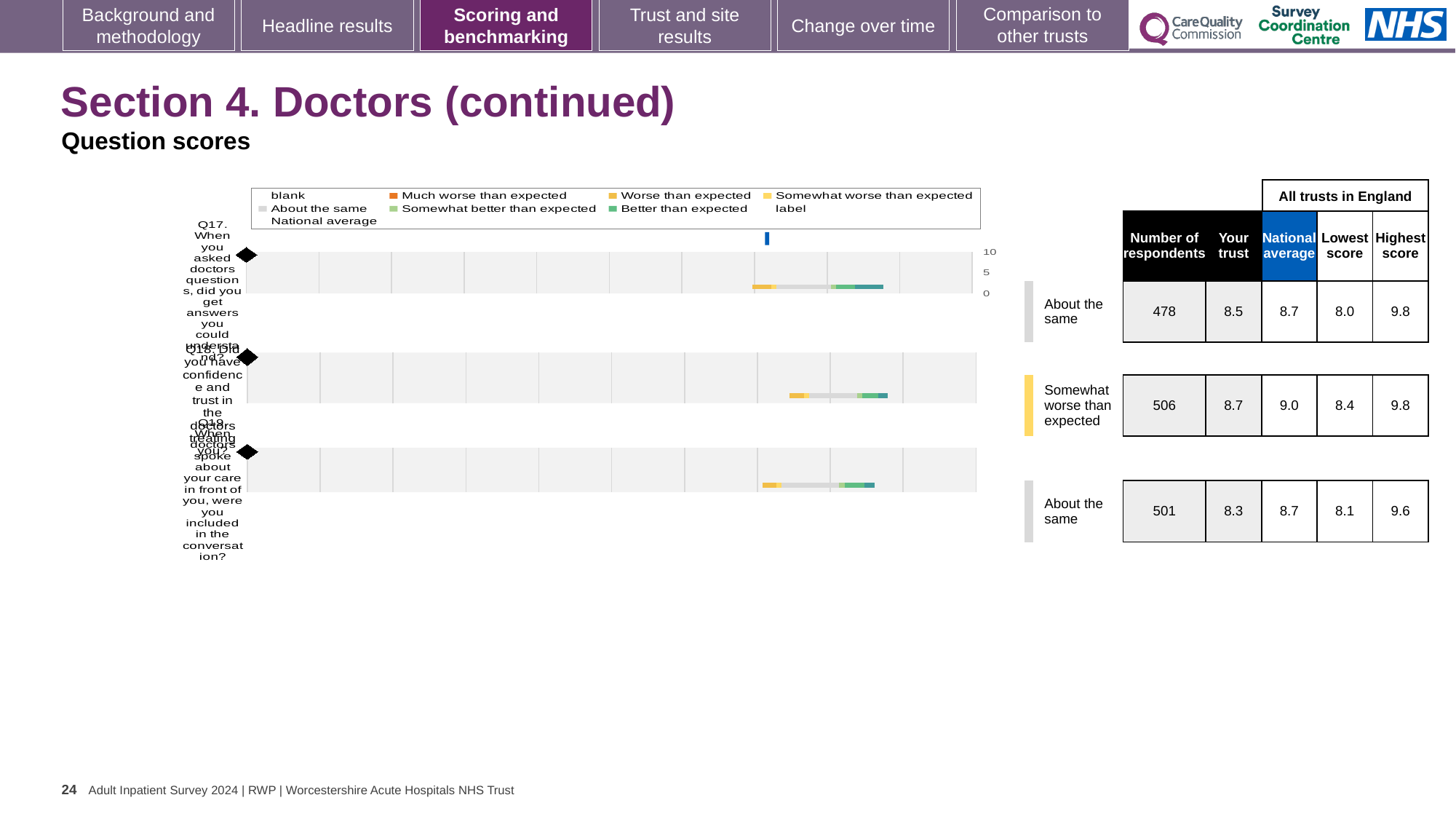
How many questions (categories) are plotted in the chart? 3 According to the table beside the chart, what is the national average for Q18? 9.0 Which legend entry is shown in orange? Much worse than expected How many entries does the chart legend list? 9 What is the difference between the national average and the 'Your trust' score for Q18? 0.3 Which question has the highest number of respondents in the table beside the chart? Q18 What kind of chart is shown on the slide? bar chart What benchmark category is Q18 assigned to on the slide? Somewhat worse than expected According to the table beside the chart, what is the 'Your trust' score for Q17? 8.5 Is the 'Your trust' score higher for Q17 or Q19? Q17 According to the table beside the chart, how many respondents answered Q19? 501 Which question has the lowest 'Your trust' score in the table beside the chart? Q19